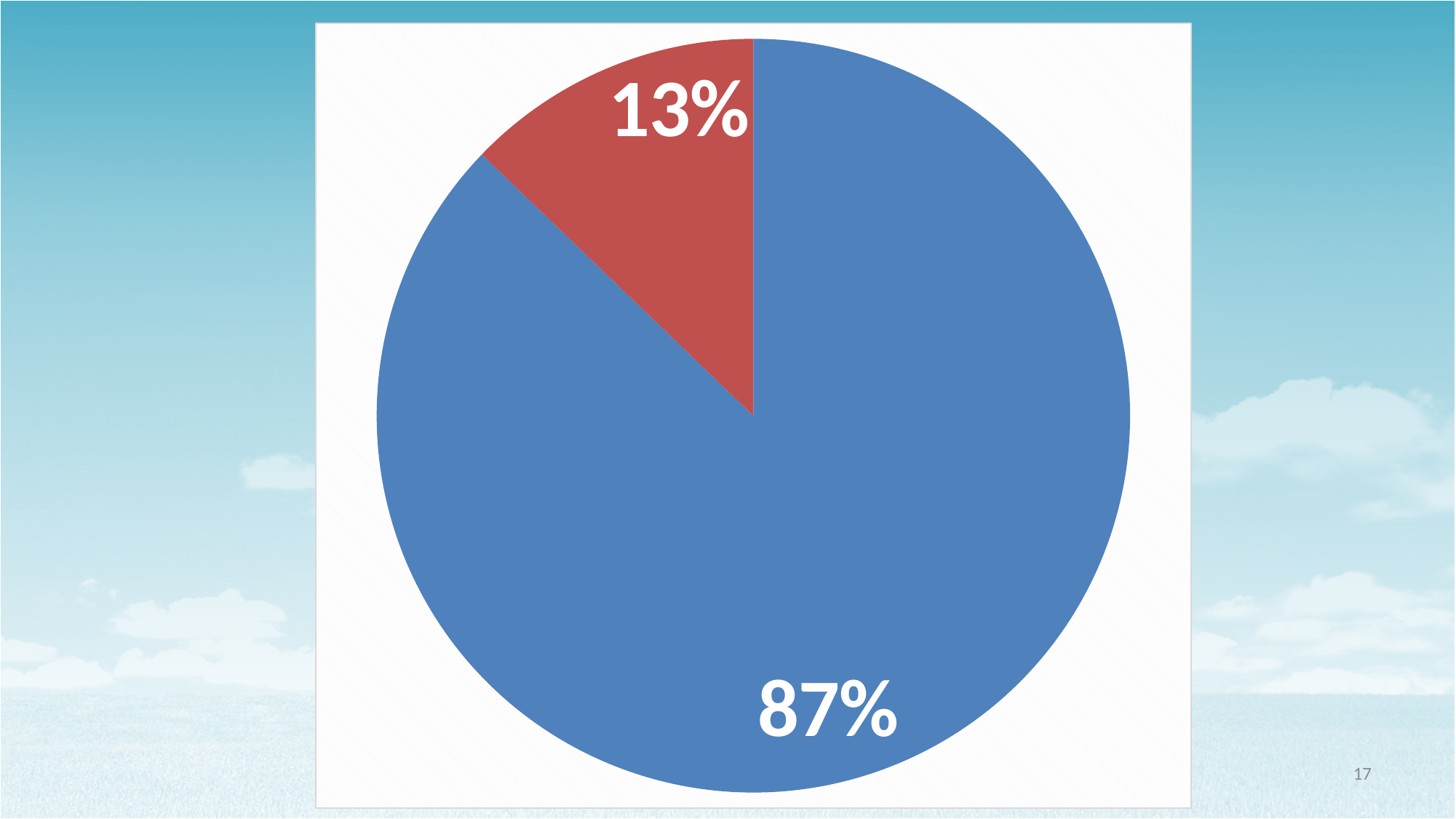
What is the difference in percentage points between the blue slice and the red slice? 74 What kind of chart is shown on the slide? pie chart What percentage is shown on the red slice of the pie chart? 13% Which slice is larger, the blue slice or the red slice? the blue slice Is the value of the blue slice greater or less than 50%? greater What percentage is shown on the blue slice of the pie chart? 87% What colour is the slice labelled 13%? red How many slices does the pie chart have? 2 What share of the pie does the red slice represent? 13% Which slice of the pie chart is the largest? the blue slice Does the pie chart have a legend? No Which slice of the pie chart is the smallest? the red slice